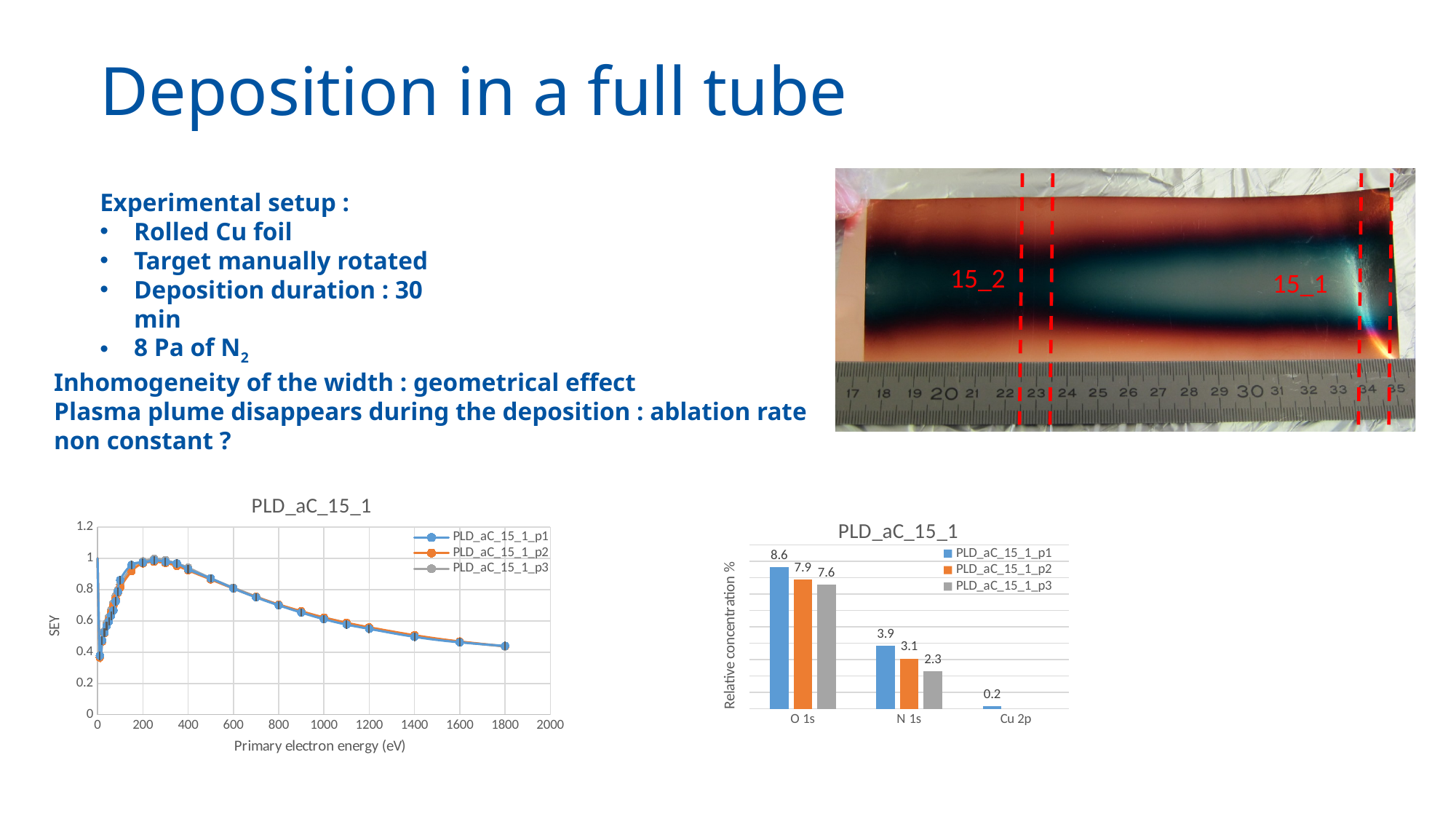
In the bar chart on the right, what is the value for PLD_aC_15_1_p1 at O 1s? 8.6 What kind of chart is the chart on the left of the slide? Line chart In the line chart on the left, do the SEY values rise or fall as the primary electron energy increases from 400 eV to 1800 eV? fall In the bar chart on the right, which is larger at O 1s: PLD_aC_15_1_p2 or PLD_aC_15_1_p3? PLD_aC_15_1_p2 In the line chart on the left, is the SEY value at 1800 eV greater or less than 0.6? less In the bar chart on the right, which category has the highest value for PLD_aC_15_1_p1? O 1s In the bar chart on the right, what is the value for PLD_aC_15_1_p1 at Cu 2p? 0.2 In the bar chart on the right, what is the difference between PLD_aC_15_1_p1 and PLD_aC_15_1_p3 at N 1s? 1.6 In the bar chart on the right, what is the value for PLD_aC_15_1_p3 at N 1s? 2.3 In the bar chart on the right, what is the value for PLD_aC_15_1_p2 at O 1s? 7.9 In the bar chart on the right, which category has the lowest value for PLD_aC_15_1_p1? Cu 2p How many series does the legend of the bar chart on the right list? 3